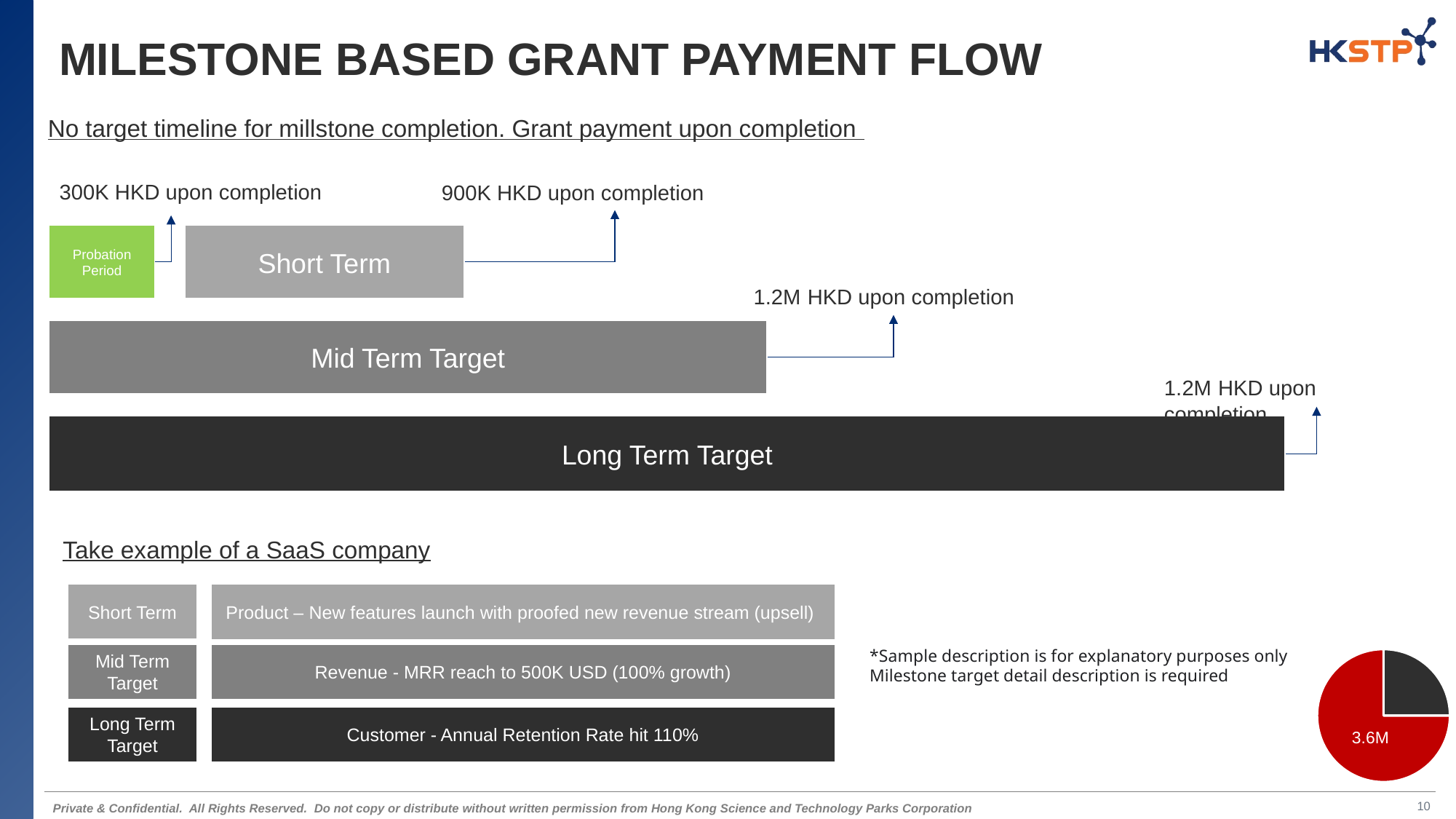
How many slices does the pie chart in the bottom-right corner have? 2 What kind of chart is shown in the bottom-right corner of the slide? pie chart Which slice of the pie chart is larger, the red slice or the dark slice? the red slice What colour is the slice of the pie chart that carries the 3.6M label? red What value is printed on the red slice of the pie chart? 3.6M Which slice of the pie chart is the smallest? the dark slice Does the pie chart have a legend? No Which slice of the pie chart is the largest? the red slice labelled 3.6M